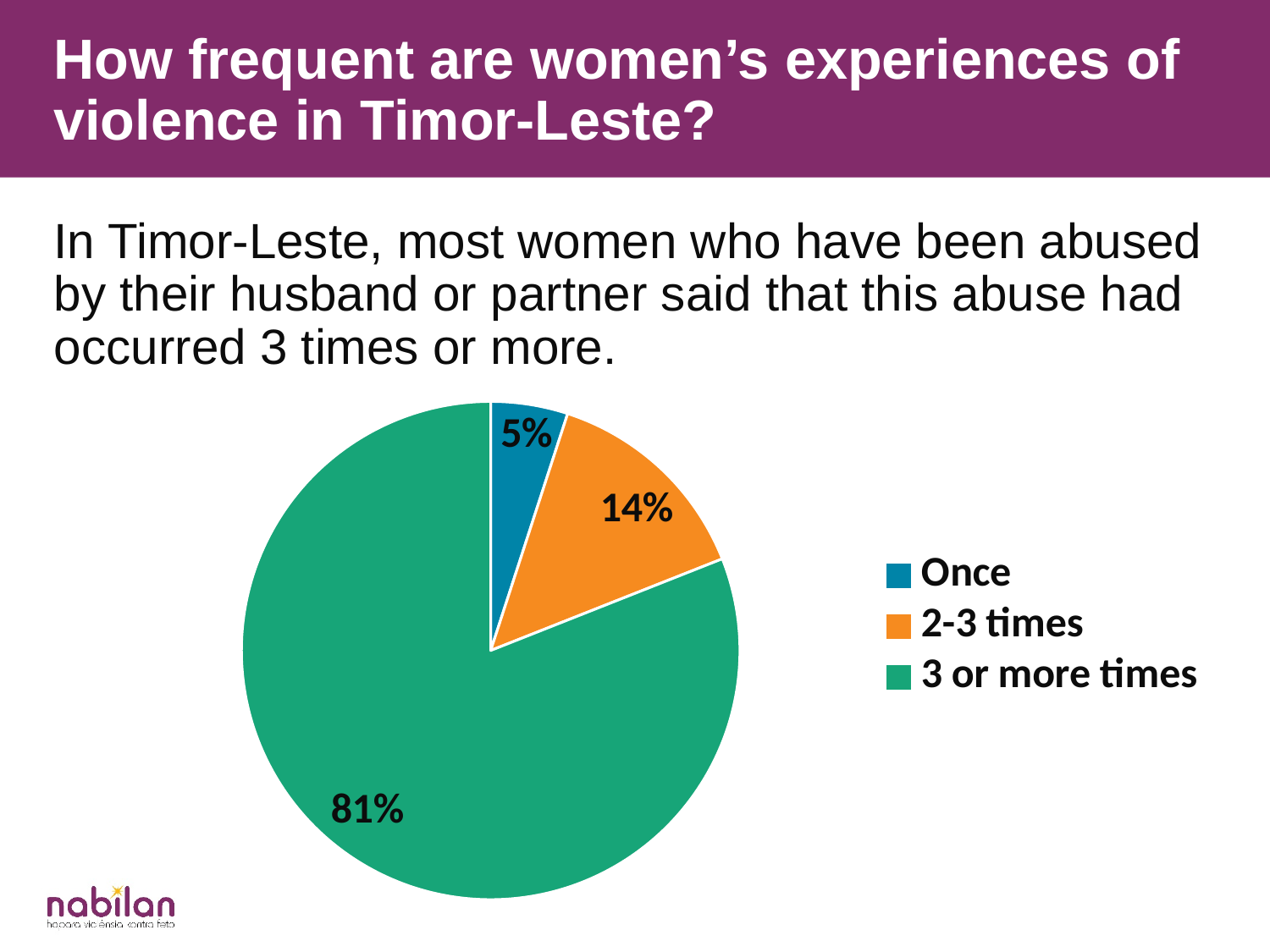
What colour is the "Once" slice? blue How many entries does the legend list? 3 What share of the pie is labelled "2-3 times"? 14% How many slices does the pie chart have? 3 What share of the pie is labelled "3 or more times"? 81% Which category has the smallest slice of the pie? Once What share of the pie is labelled "Once"? 5% What kind of chart is shown on the slide? pie chart Which is larger, the "2-3 times" slice or the "Once" slice? 2-3 times What colour is the "3 or more times" slice? green Which category has the largest slice of the pie? 3 or more times What is the difference in percentage points between the "3 or more times" slice and the "2-3 times" slice? 67